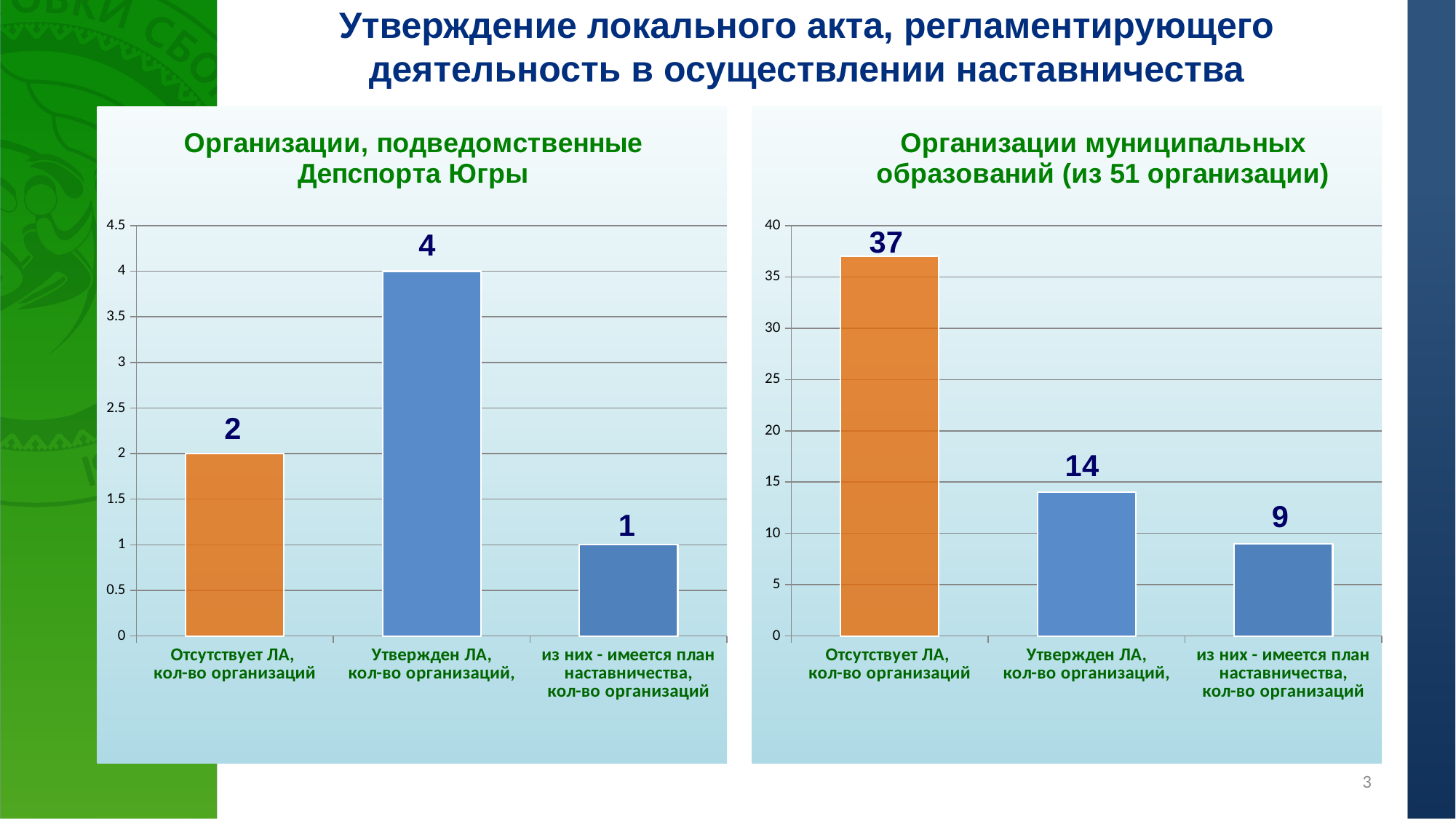
How many categories are shown in the left chart (Организации, подведомственные Депспорта Югры)? 3 In the right chart (Организации муниципальных образований), what is the difference between 'Отсутствует ЛА' and 'Утвержден ЛА'? 23 In the left chart (Организации, подведомственные Депспорта Югры), what is the value for 'Отсутствует ЛА, кол-во организаций'? 2 In the right chart (Организации муниципальных образований), which is larger: 'Утвержден ЛА, кол-во организаций' or 'из них - имеется план наставничества, кол-во организаций'? Утвержден ЛА, кол-во организаций What kind of chart is the right chart (Организации муниципальных образований)? Bar chart What is the title of the right chart? Организации муниципальных образований (из 51 организации) In the right chart (Организации муниципальных образований), what is the value for 'из них - имеется план наставничества, кол-во организаций'? 9 In the right chart (Организации муниципальных образований), which category has the highest value? Отсутствует ЛА, кол-во организаций In the left chart (Организации, подведомственные Депспорта Югры), what is the difference between 'Утвержден ЛА' and 'Отсутствует ЛА'? 2 In the right chart (Организации муниципальных образований), what is the value for 'Отсутствует ЛА, кол-во организаций'? 37 In the left chart (Организации, подведомственные Депспорта Югры), which category has the lowest value? из них - имеется план наставничества, кол-во организаций In the left chart (Организации, подведомственные Депспорта Югры), what is the value for 'Утвержден ЛА, кол-во организаций'? 4